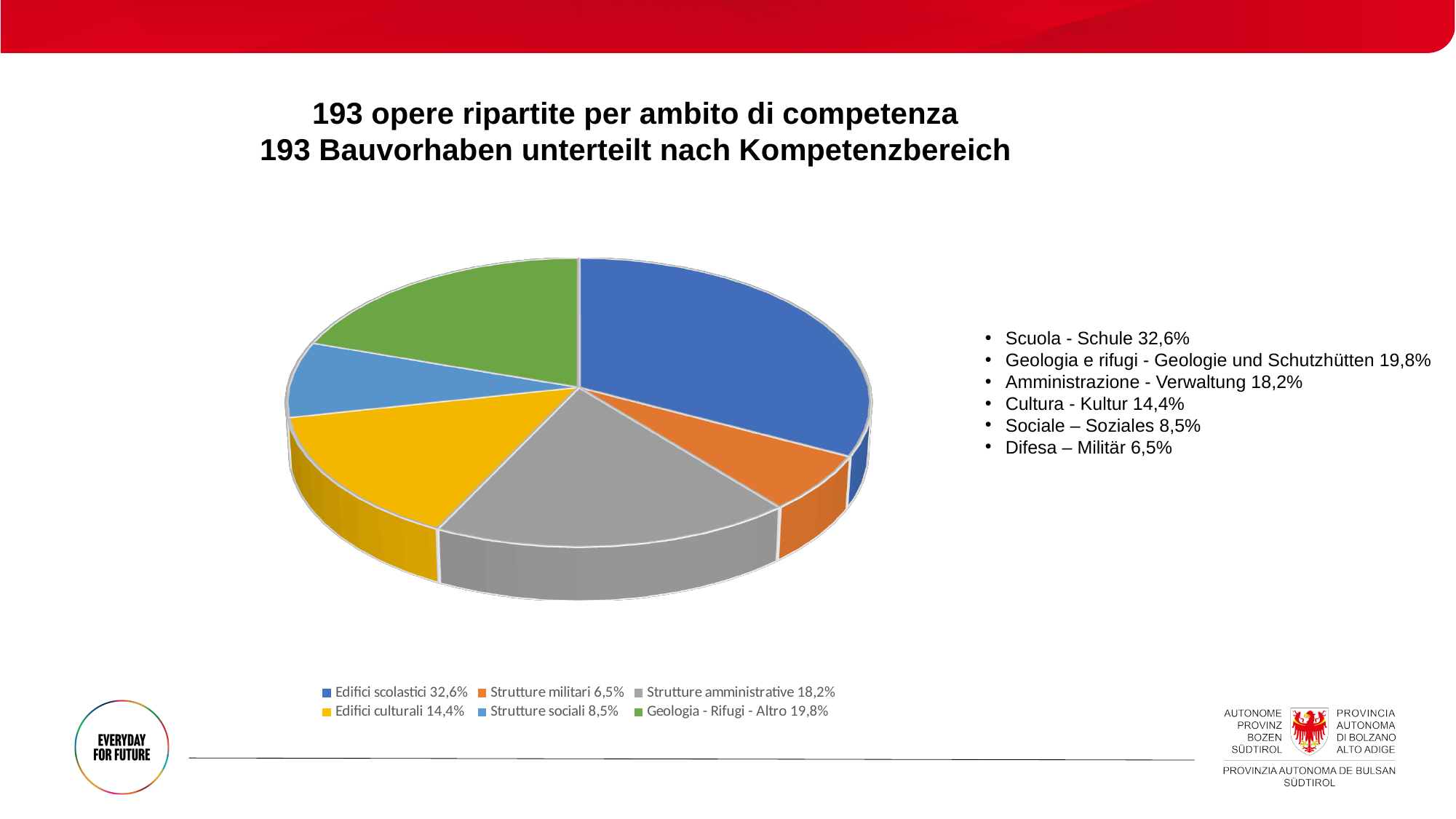
What kind of chart is shown on the slide? Pie chart Which category has the smallest share of the pie? Strutture militari What is the difference in percentage points between the Edifici scolastici share and the Geologia - Rifugi - Altro share? 12,8 What share of the pie does Edifici scolastici represent? 32,6% Which is larger, the share for Strutture amministrative or the share for Edifici culturali? Strutture amministrative What colour is the Edifici culturali slice? Yellow How many slices does the pie chart have? 6 What share of the pie does Strutture sociali represent? 8,5% What share of the pie does Geologia - Rifugi - Altro represent? 19,8% Which category has the largest share of the pie? Edifici scolastici How many works (opere) does the chart title say are divided by area of competence? 193